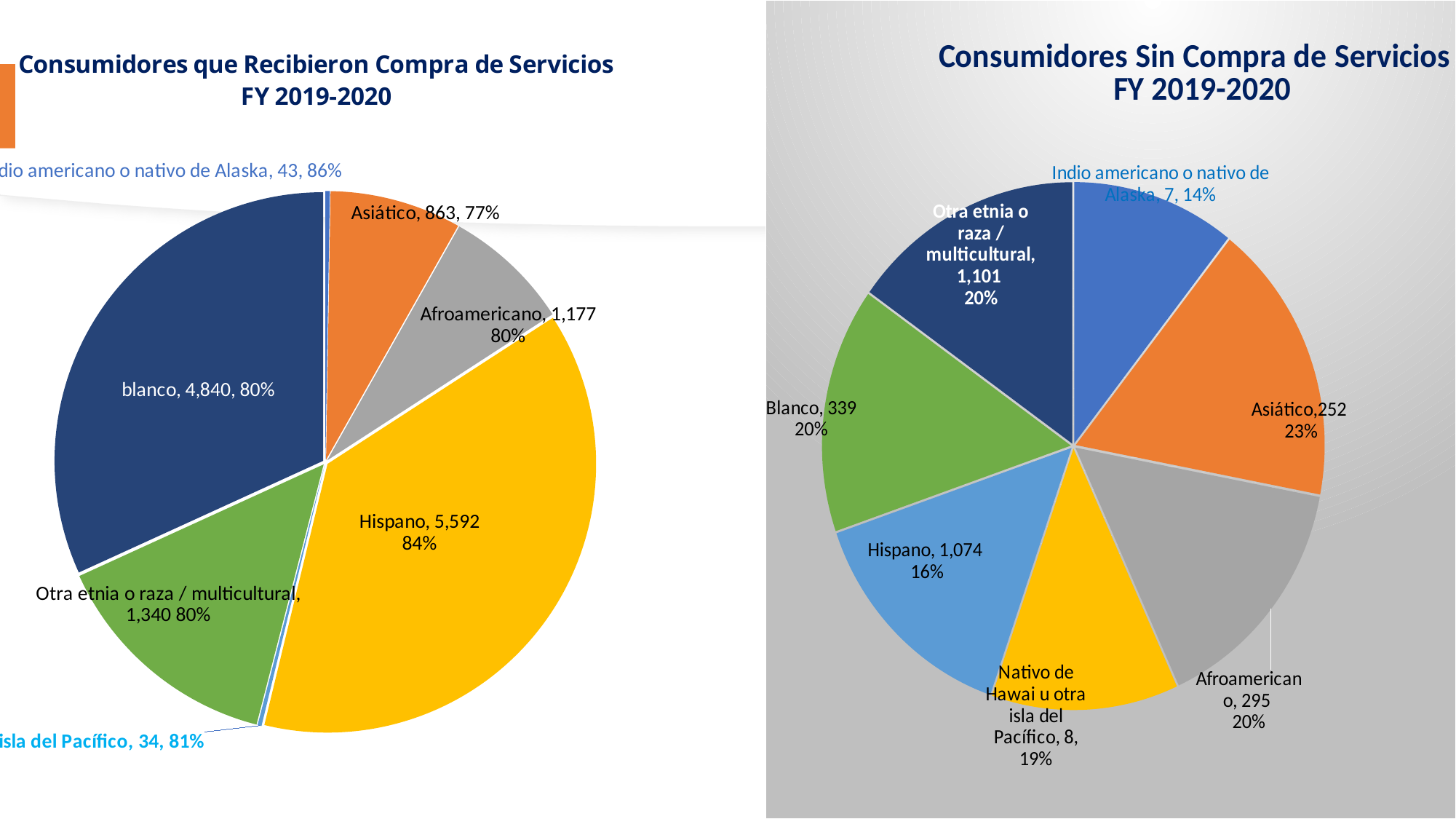
In the chart titled 'Consumidores que Recibieron Compra de Servicios FY 2019-2020', what is the difference between the values for Hispano and blanco? 752 How many categories are shown in the chart titled 'Consumidores Sin Compra de Servicios FY 2019-2020'? 7 In the chart titled 'Consumidores Sin Compra de Servicios FY 2019-2020', what percentage is shown for Indio americano o nativo de Alaska? 14% In the chart titled 'Consumidores que Recibieron Compra de Servicios FY 2019-2020', what is the value for Hispano? 5,592 In the chart titled 'Consumidores Sin Compra de Servicios FY 2019-2020', what is the value for Asiático? 252 In the chart titled 'Consumidores que Recibieron Compra de Servicios FY 2019-2020', what is the value for blanco? 4,840 In the chart titled 'Consumidores Sin Compra de Servicios FY 2019-2020', which category has the lowest value? Indio americano o nativo de Alaska In the chart titled 'Consumidores Sin Compra de Servicios FY 2019-2020', what is the difference between the values for Otra etnia o raza / multicultural and Hispano? 27 In the chart titled 'Consumidores que Recibieron Compra de Servicios FY 2019-2020', what percentage is shown for Asiático? 77% What type of chart is the chart titled 'Consumidores Sin Compra de Servicios FY 2019-2020'? Pie chart In the chart titled 'Consumidores que Recibieron Compra de Servicios FY 2019-2020', which category has the highest value? Hispano In the chart titled 'Consumidores que Recibieron Compra de Servicios FY 2019-2020', which is larger, the value for Afroamericano or the value for Asiático? Afroamericano